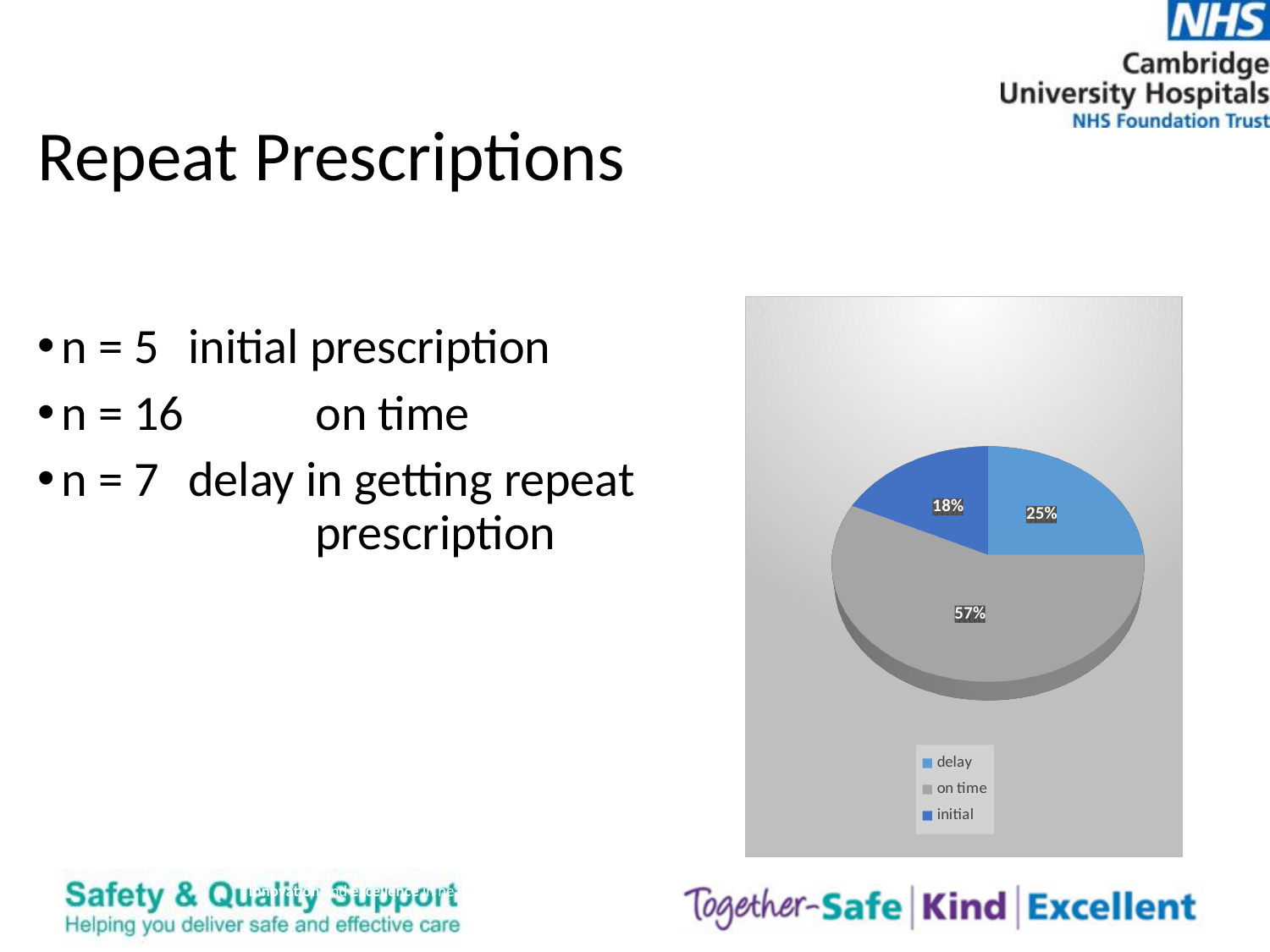
How many slices does the pie chart have? 3 Which slice is larger in the pie chart, 'delay' or 'initial'? delay What percentage does the 'initial' slice of the pie chart show? 18% What percentage of the pie chart is labelled for the 'on time' slice? 57% By how many percentage points does the 'delay' slice exceed the 'initial' slice? 7 percentage points By how many percentage points does the 'on time' slice exceed the 'delay' slice? 32 percentage points Which category has the largest slice in the pie chart? on time Which category has the smallest slice in the pie chart? initial What kind of chart is shown on the slide? pie chart What percentage does the 'delay' slice of the pie chart show? 25% How many entries does the pie chart's legend list? 3 What colour is the 'on time' slice in the pie chart? grey